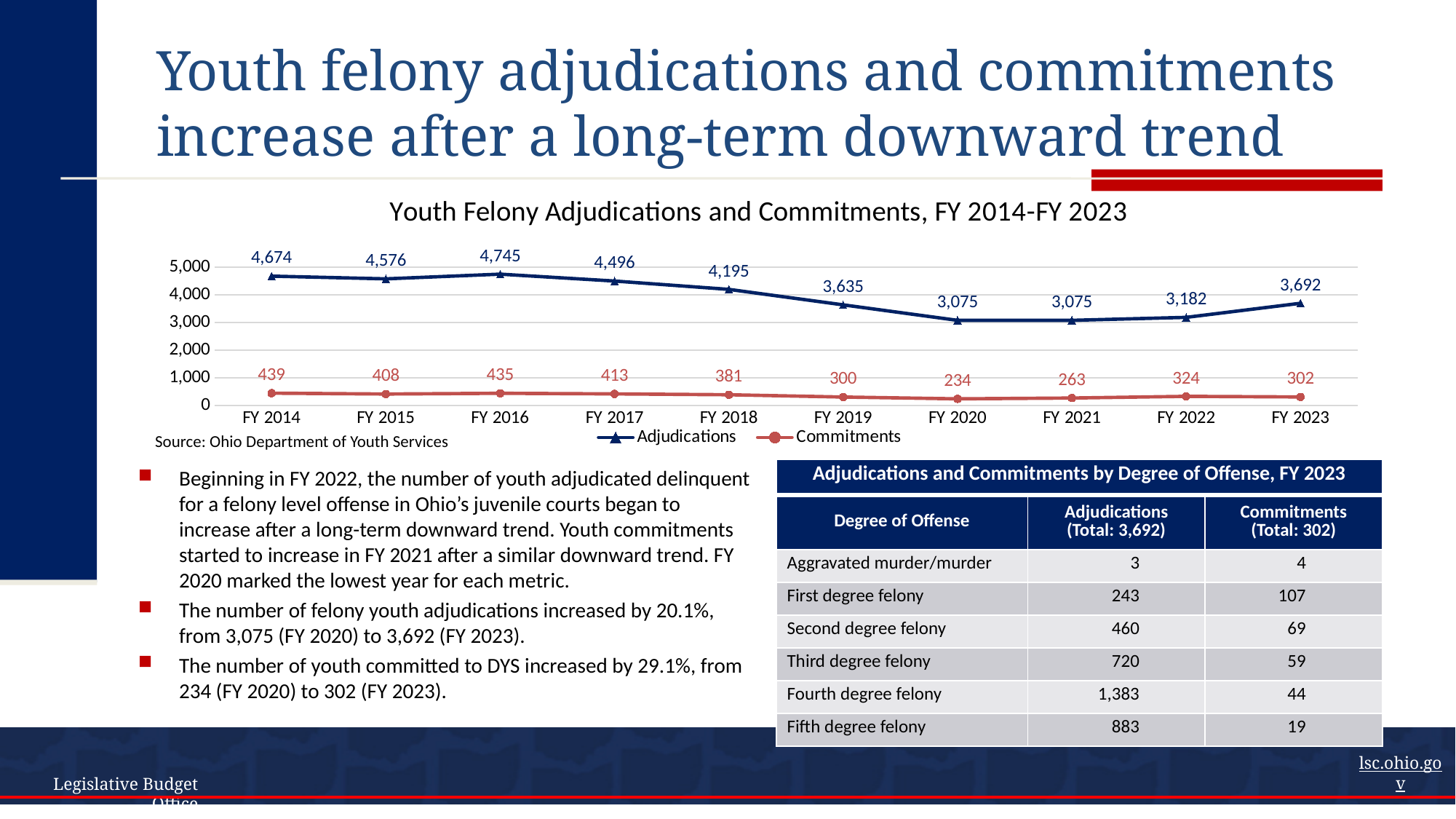
Which is larger, commitments in FY 2014 or commitments in FY 2016? FY 2014 Which fiscal year has the lowest number of commitments? FY 2020 How many fiscal years are shown on the x axis? 10 Do adjudications rise or fall from FY 2016 to FY 2020? fall What is the number of adjudications in FY 2016? 4,745 What is the number of commitments in FY 2020? 234 What kind of chart is shown? line chart Is the value for adjudications in FY 2019 greater or less than 4,000? less What is the difference between adjudications in FY 2023 and FY 2020? 617 How many series does the legend list? 2 What is the title of the chart? Youth Felony Adjudications and Commitments, FY 2014-FY 2023 Which fiscal year has the highest number of adjudications? FY 2016